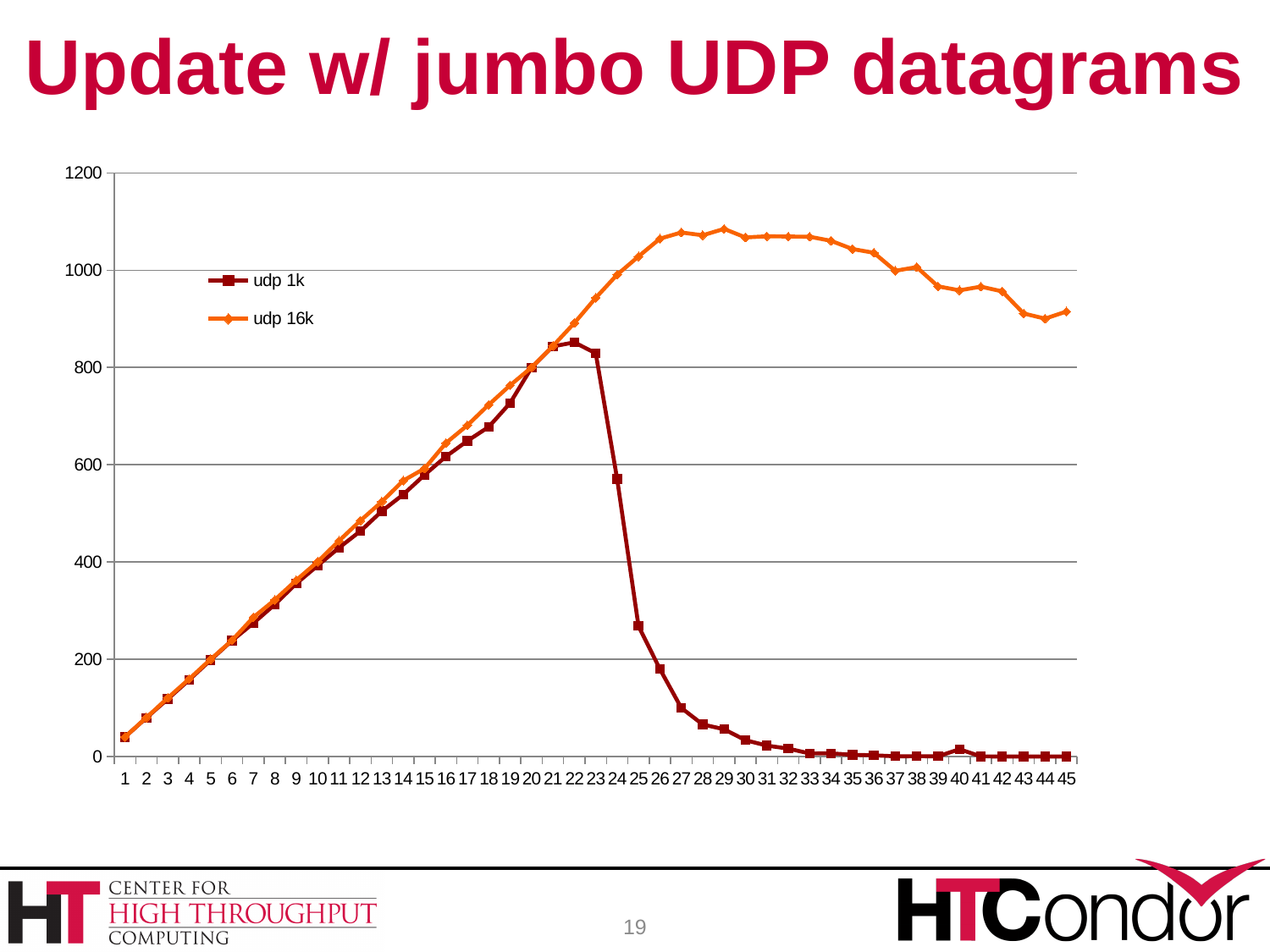
How many points are there along the x axis? 45 What kind of chart is shown on the slide? line chart Is the value for udp 1k at x = 22 greater or less than 800? greater Is the value for udp 16k at x = 30 greater or less than 1000? greater Is the value for udp 1k at x = 30 greater or less than 200? less What is the title of the slide containing the chart? Update w/ jumbo UDP datagrams Which series reaches the higher peak value? udp 16k Does the udp 1k series rise or fall between x = 23 and x = 30? fall At x = 35, which series has the higher value, udp 1k or udp 16k? udp 16k What are the two series named in the legend? udp 1k and udp 16k How many series does the legend list? 2